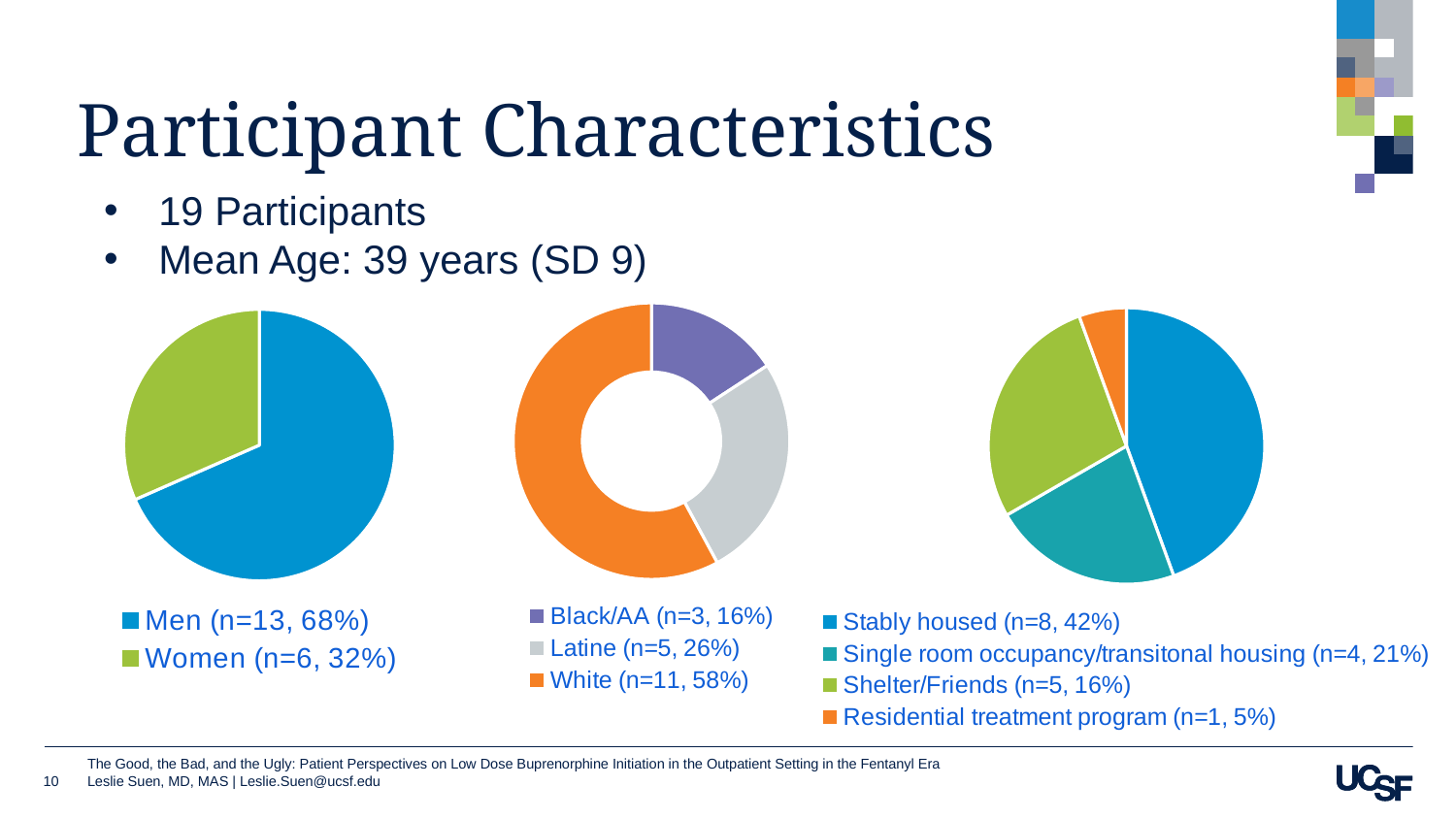
On the left pie chart, what is the difference in the number of men and women? 7 On the left pie chart, how many participants are men? 13 On the middle chart, what percentage of participants are White? 58% What kind of chart is the middle chart on the slide? Donut chart On the right pie chart, which category has the largest share? Stably housed On the middle chart, which category has the smallest share? Black/AA On the left pie chart, which group is larger, men or women? Men On the right pie chart, what percentage of participants are in a residential treatment program? 5% How many categories does the legend of the right pie chart list? 4 How many categories does the legend of the middle chart list? 3 On the right pie chart, how many participants are stably housed? 8 On the left pie chart, what percentage of participants are women? 32%